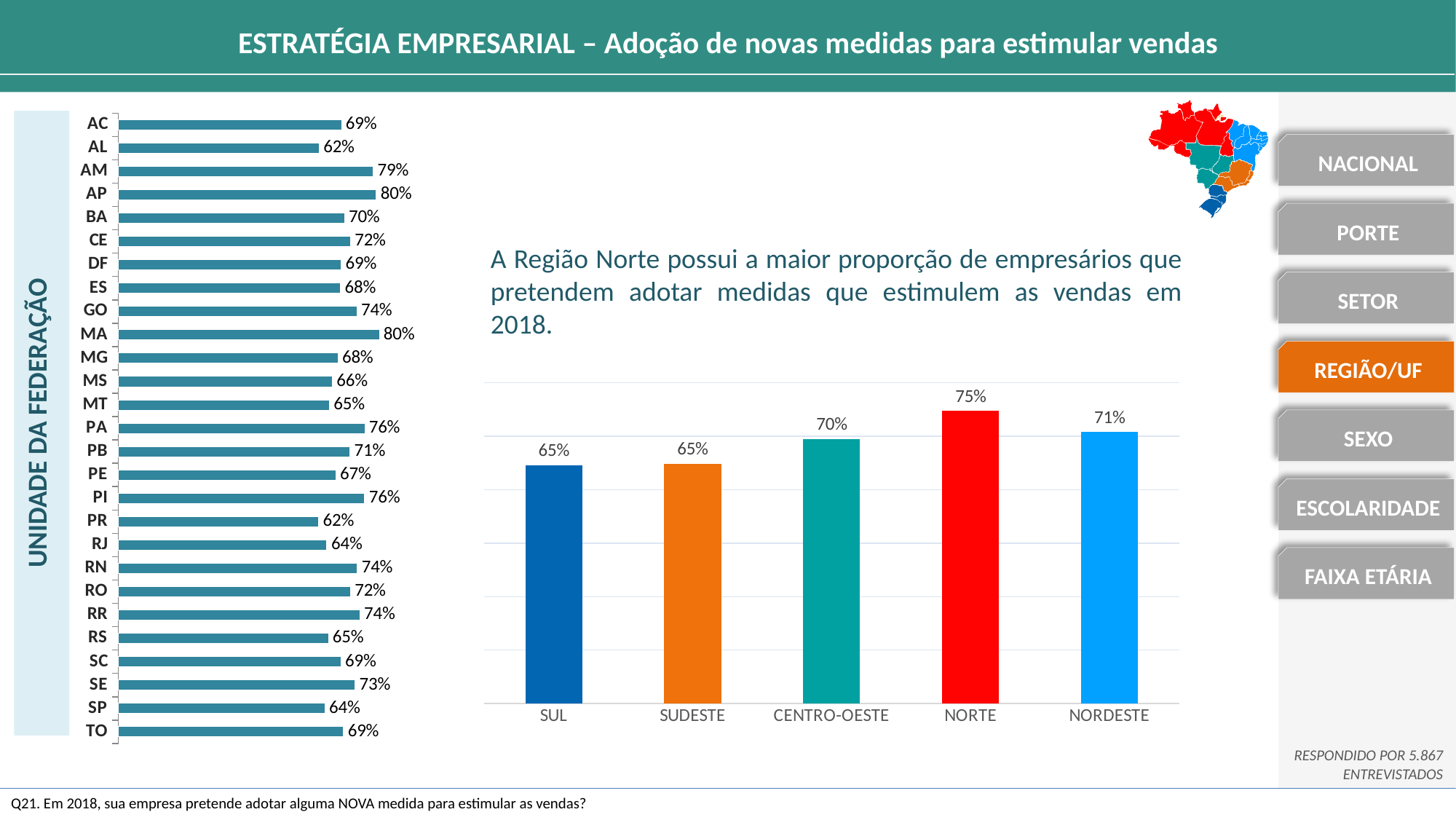
In the region chart on the right, what colour is the NORTE bar? Red In the region chart on the right, which is larger, CENTRO-OESTE or NORDESTE? NORDESTE In the state chart on the left (Unidade da Federação), what is the value for MS? 66% In the state chart on the left (Unidade da Federação), what is the value for AM? 79% In the region chart on the right, which region has the highest value? NORTE How many regions are shown in the bar chart on the right? 5 How many states are listed in the bar chart on the left (Unidade da Federação)? 27 What kind of chart is the region chart on the right? Bar chart In the region chart on the right, what is the difference between NORTE and SUL? 10% In the state chart on the left (Unidade da Federação), what is the difference between AP and AL? 18% In the region chart on the right, what is the value for NORTE? 75% In the state chart on the left (Unidade da Federação), which is larger, PA or RJ? PA